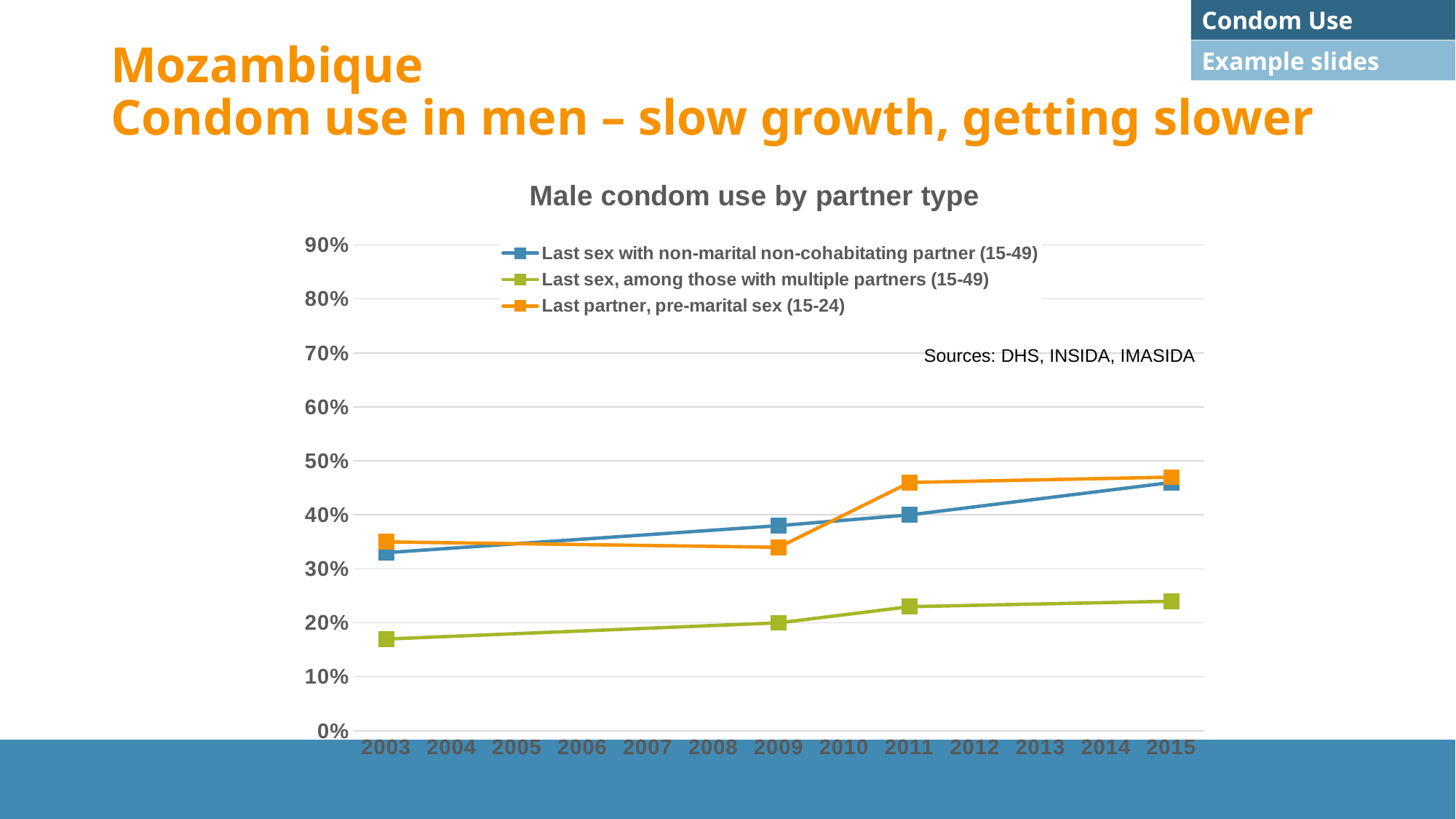
Is the 2015 value for 'Last sex with non-marital non-cohabitating partner (15-49)' greater or less than 40%? greater Which series has the lowest value in 2015? Last sex, among those with multiple partners (15-49) What kind of chart is shown on the slide? line chart In 2009, which is larger: 'Last sex with non-marital non-cohabitating partner (15-49)' or 'Last partner, pre-marital sex (15-24)'? Last sex with non-marital non-cohabitating partner (15-49) Is the 2003 value for 'Last sex with non-marital non-cohabitating partner (15-49)' greater or less than 30%? greater How many years have plotted data points on the chart? 4 Is the 2011 value for 'Last partner, pre-marital sex (15-24)' greater or less than 40%? greater In 2015, which is larger: 'Last partner, pre-marital sex (15-24)' or 'Last sex, among those with multiple partners (15-49)'? Last partner, pre-marital sex (15-24) Does the 'Last sex, among those with multiple partners (15-49)' series rise or fall from 2003 to 2015? rise What is the title of the chart? Male condom use by partner type How many series does the legend list? 3